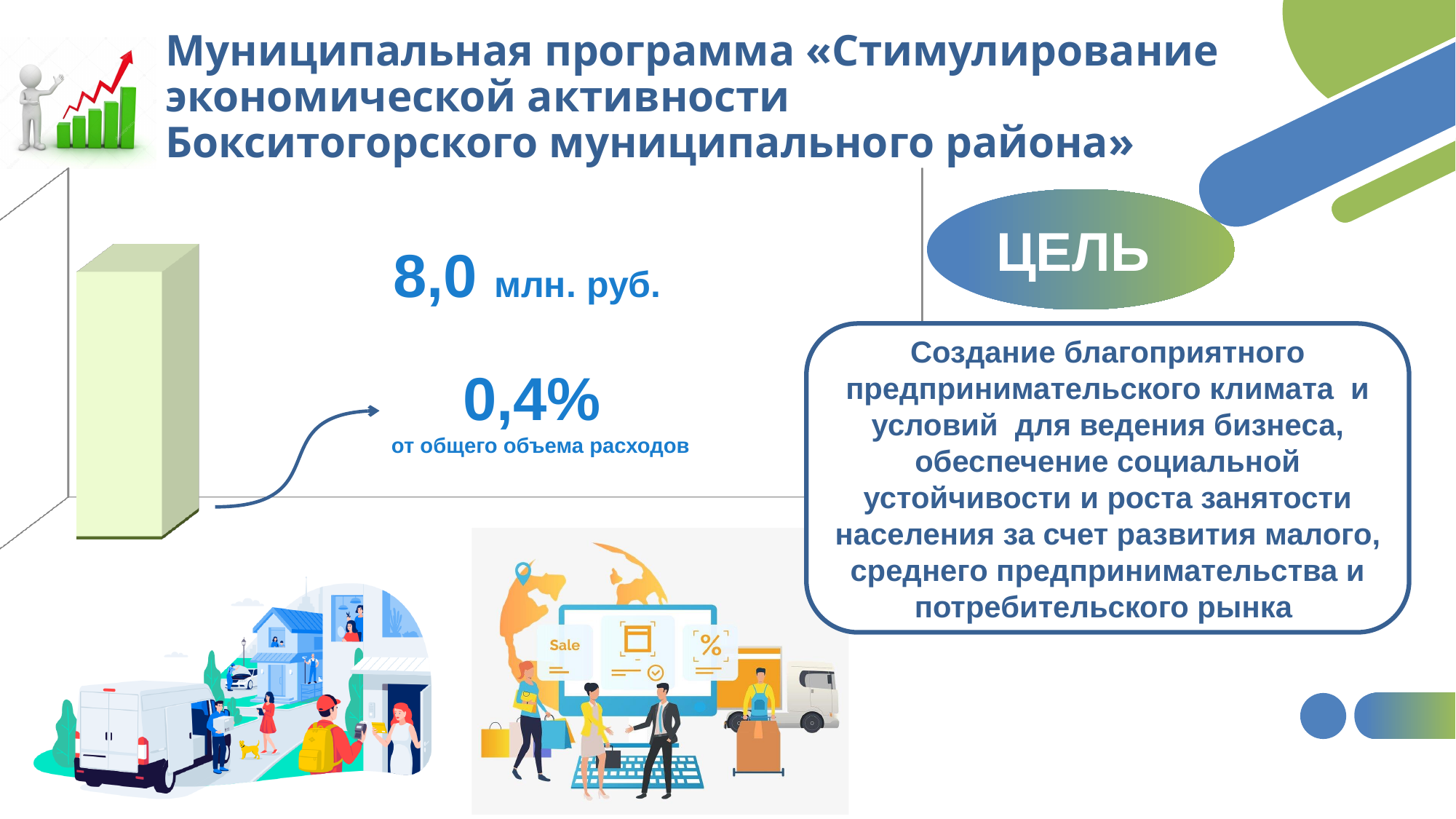
What text is printed under the 0,4% label on the slide? от общего объема расходов What kind of chart is shown on the left of the slide? bar chart How many bars does the chart on the left of the slide contain? 1 What is the name of the municipal programme in the slide title? Стимулирование экономической активности Бокситогорского муниципального района Is the share of total expenditures shown for the bar greater or less than 1%? less What value in million rubles is printed next to the bar on the slide? 8,0 млн. руб. What percentage of total expenditures does the bar on the slide represent, according to the label? 0,4%